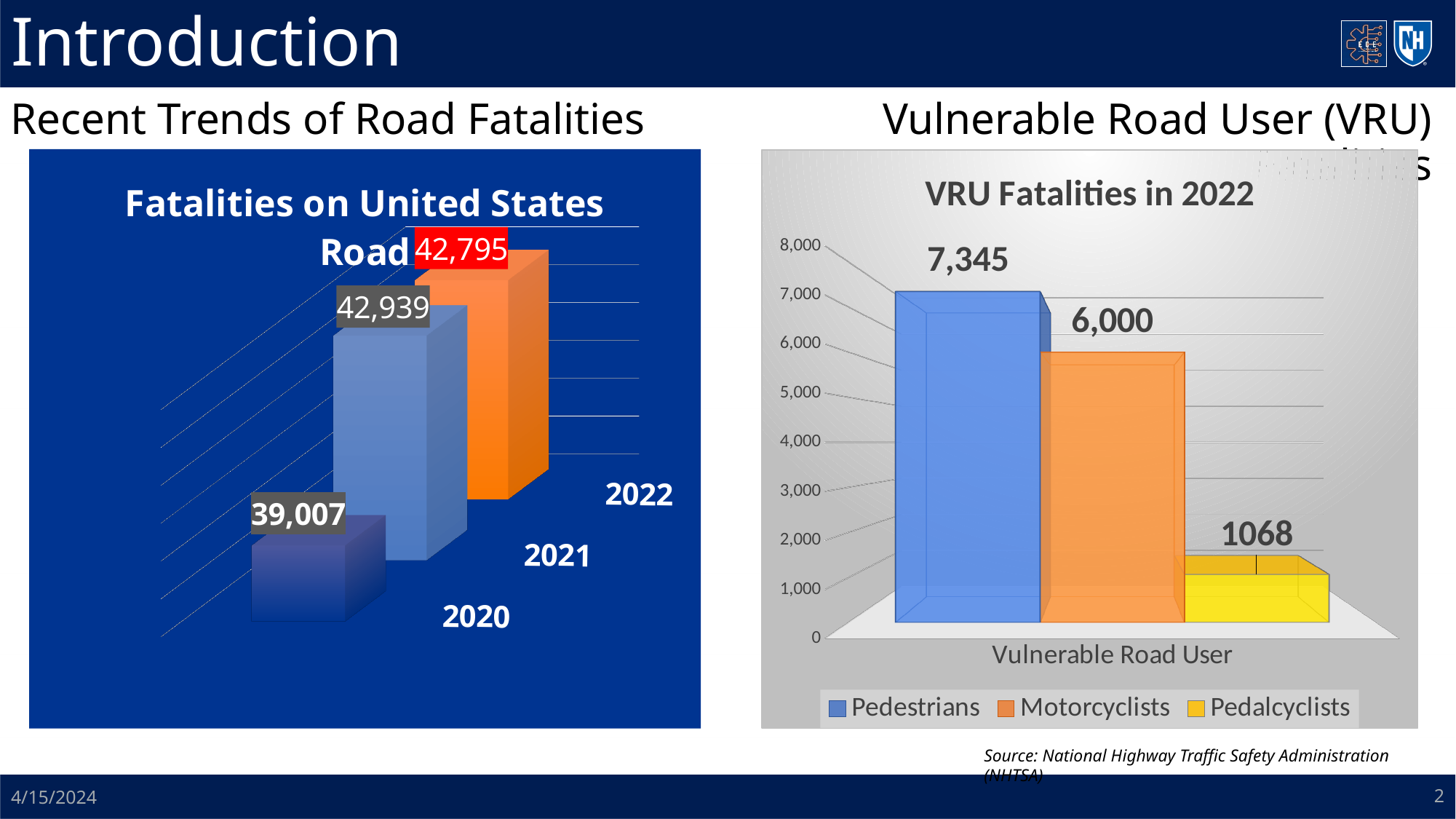
In the 'VRU Fatalities in 2022' chart, what is the value for Pedalcyclists? 1068 In the 'Fatalities on United States Road' chart, what is the value for 2022? 42,795 In the 'VRU Fatalities in 2022' chart, what is the difference between the Pedestrians and Motorcyclists values? 1,345 In the 'VRU Fatalities in 2022' chart, how many series does the legend list? 3 What kind of chart is the 'VRU Fatalities in 2022' chart? Bar chart In the 'Fatalities on United States Road' chart, what is the value for 2020? 39,007 In the 'VRU Fatalities in 2022' chart, which group has the lowest value? Pedalcyclists In the 'Fatalities on United States Road' chart, how many years are shown? 3 In the 'Fatalities on United States Road' chart, what is the value for 2021? 42,939 In the 'Fatalities on United States Road' chart, which year has the highest value? 2021 In the 'VRU Fatalities in 2022' chart, what is the value for Pedestrians? 7,345 In the 'Fatalities on United States Road' chart, what is the difference between the 2021 and 2020 values? 3,932